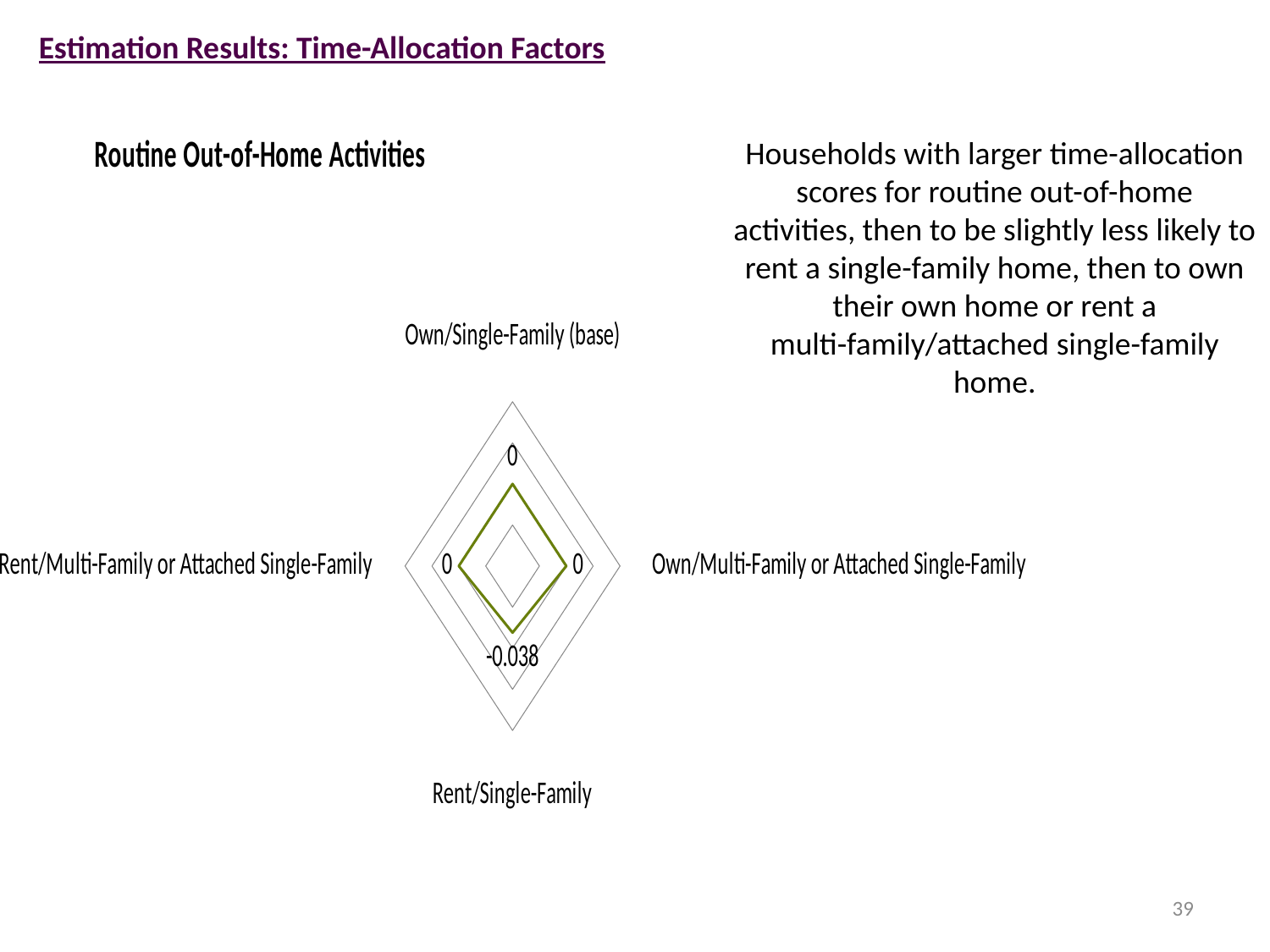
Which category has the lowest value? Rent/Single-Family What is the value for Own/Single-Family (base)? 0 Which is larger, the value for Rent/Single-Family or the value for Own/Multi-Family or Attached Single-Family? Own/Multi-Family or Attached Single-Family What kind of chart is shown on the slide? Radar chart What is the difference between the value for Own/Single-Family (base) and the value for Rent/Single-Family? 0.038 Which category is labelled as the base? Own/Single-Family What is the value for Rent/Single-Family? -0.038 How many categories does the radar chart have? 4 What is the title of the chart? Routine Out-of-Home Activities What is the value for Own/Multi-Family or Attached Single-Family? 0 What is the value for Rent/Multi-Family or Attached Single-Family? 0 How many categories have a value of 0? 3